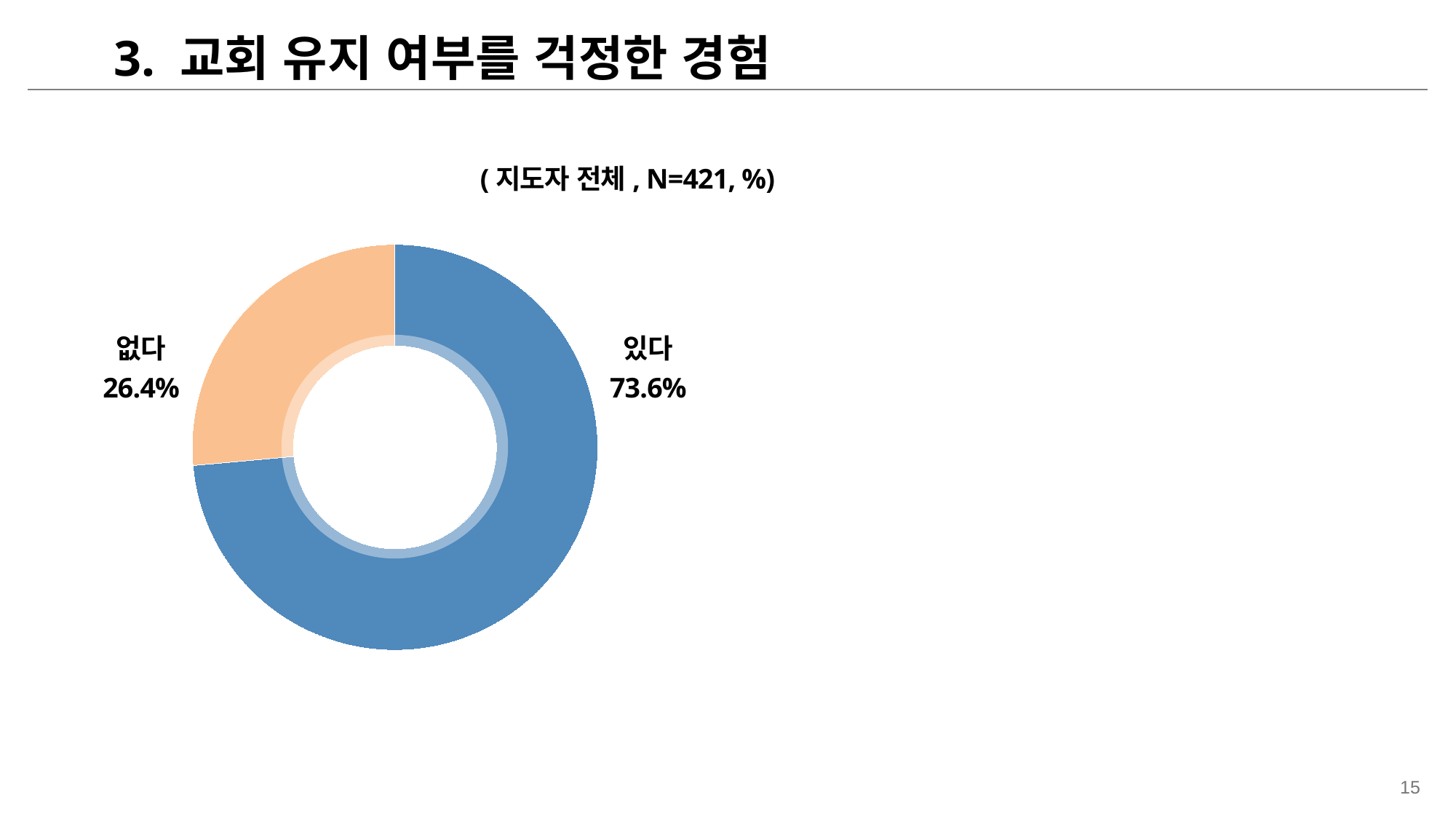
What is the sample size (N) shown above the chart? 421 Which category has the smallest share? 없다 What colour is the 있다 slice? Blue Which is larger, the value for 있다 or the value for 없다? 있다 What share of the pie does 없다 take? 26.4% What is the difference between the values for 있다 and 없다? 47.2% How many categories are shown in the chart? 2 What kind of chart is shown on the slide? Doughnut (pie) chart What is the value for 없다? 26.4% Which category has the largest share? 있다 What is the value for 있다? 73.6%